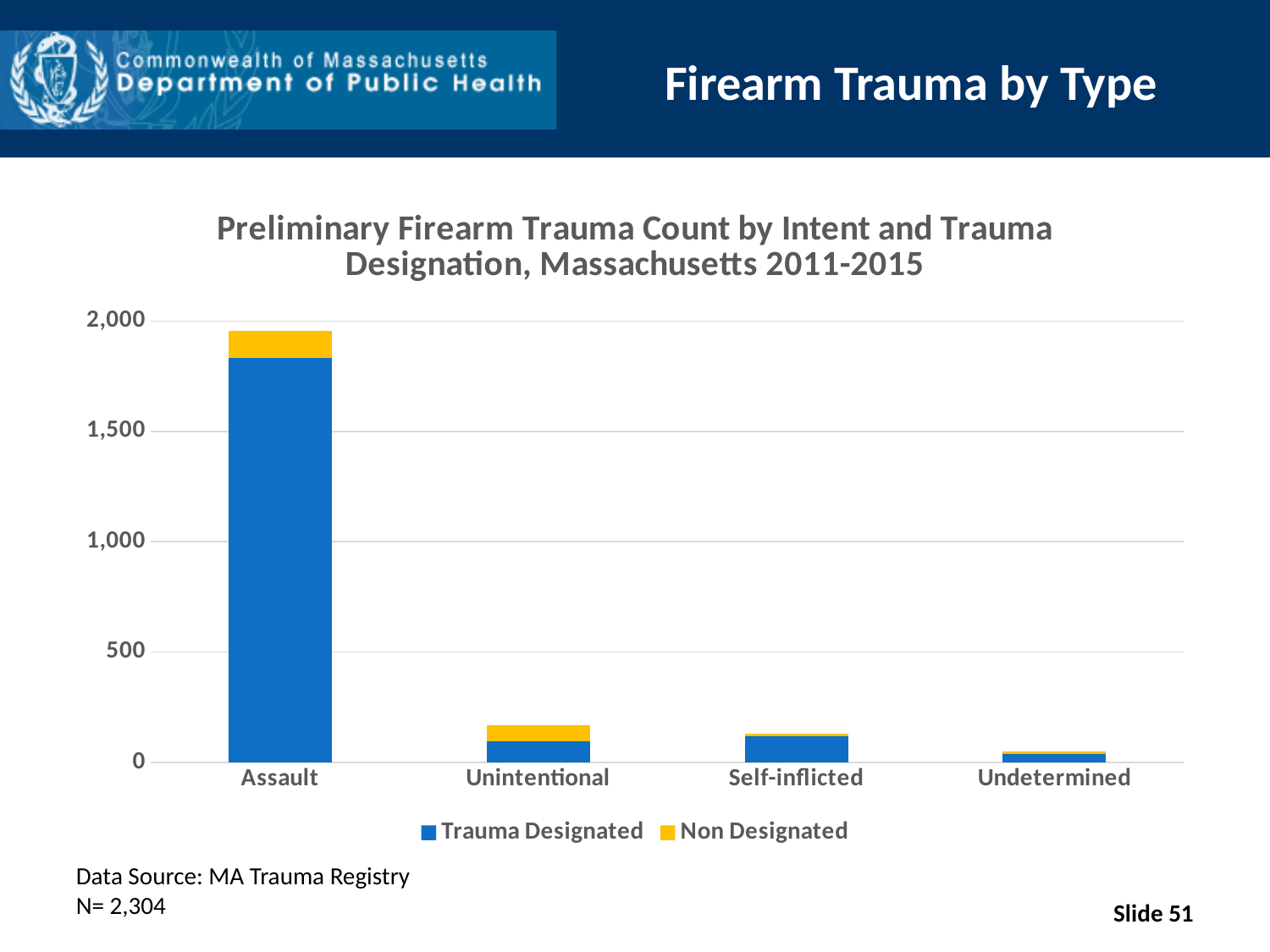
How many intent categories are shown on the x axis? 4 Is the total value for Assault greater or less than 1,500? greater Which has a larger total count, Assault or Self-inflicted? Assault How many series does the legend list? 2 Is the total value for Self-inflicted greater or less than 500? less What is the title of the chart? Preliminary Firearm Trauma Count by Intent and Trauma Designation, Massachusetts 2011-2015 What kind of chart is shown on the slide? Stacked bar chart Which intent category has the lowest total firearm trauma count? Undetermined Which series is shown in yellow in the legend? Non Designated Which intent category has the highest total firearm trauma count? Assault Is the Trauma Designated value for Assault greater or less than 1,500? greater